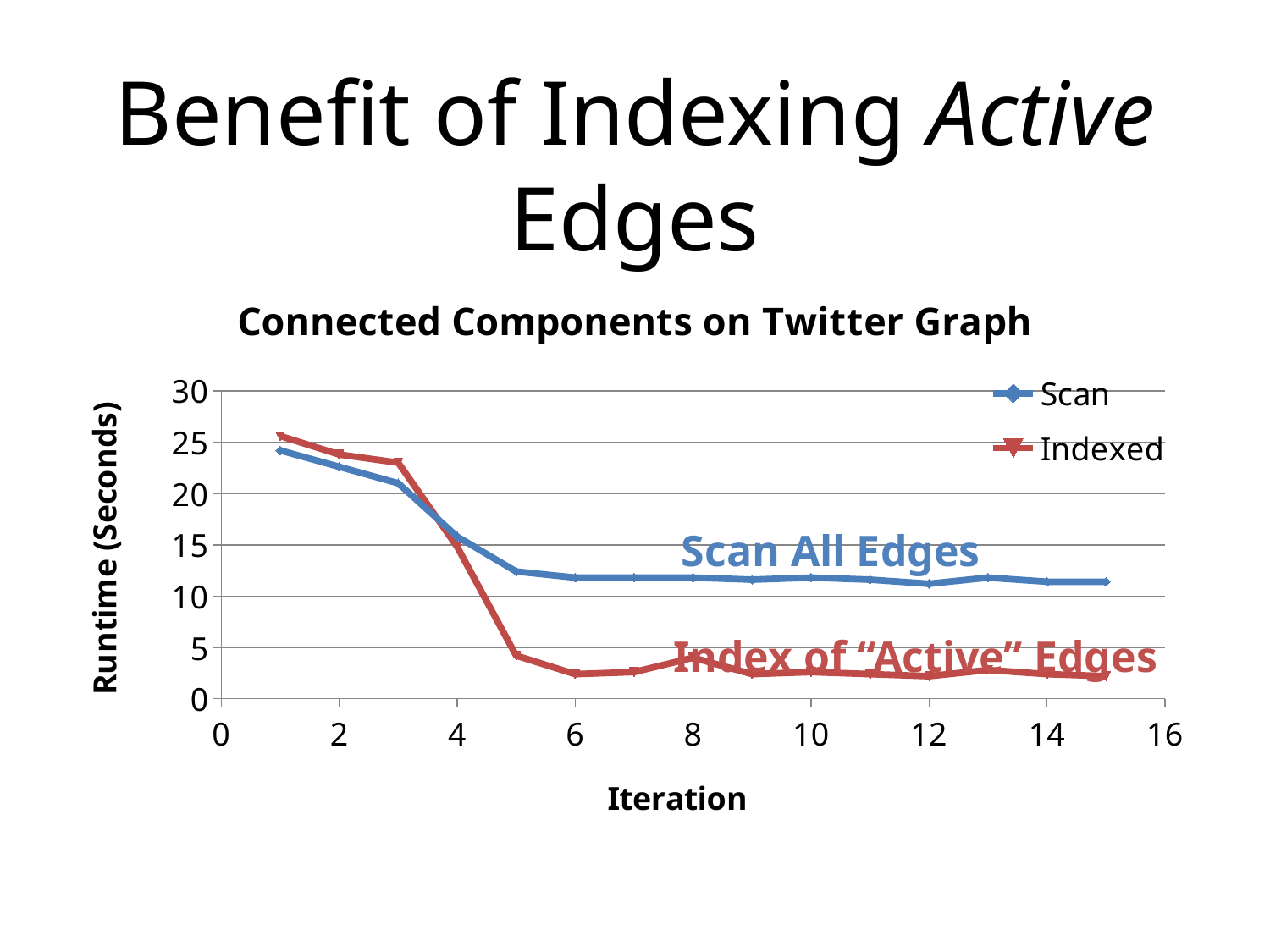
How many data points are plotted for the Scan series? 15 What is the title of the chart? Connected Components on Twitter Graph Is the runtime for Scan at iteration 1 greater or less than 20 seconds? greater At iteration 10, which series has the higher runtime, Scan or Indexed? Scan Does the runtime for the Indexed series rise or fall from iteration 1 to iteration 6? fall Is the runtime for Indexed at iteration 4 greater or less than 20 seconds? less Is the runtime for Scan at iteration 10 greater or less than 10 seconds? greater How many series does the legend list? 2 At iteration 2, which series has the higher runtime, Scan or Indexed? Indexed What are the two series named in the legend? Scan and Indexed What kind of chart is shown on the slide? line chart